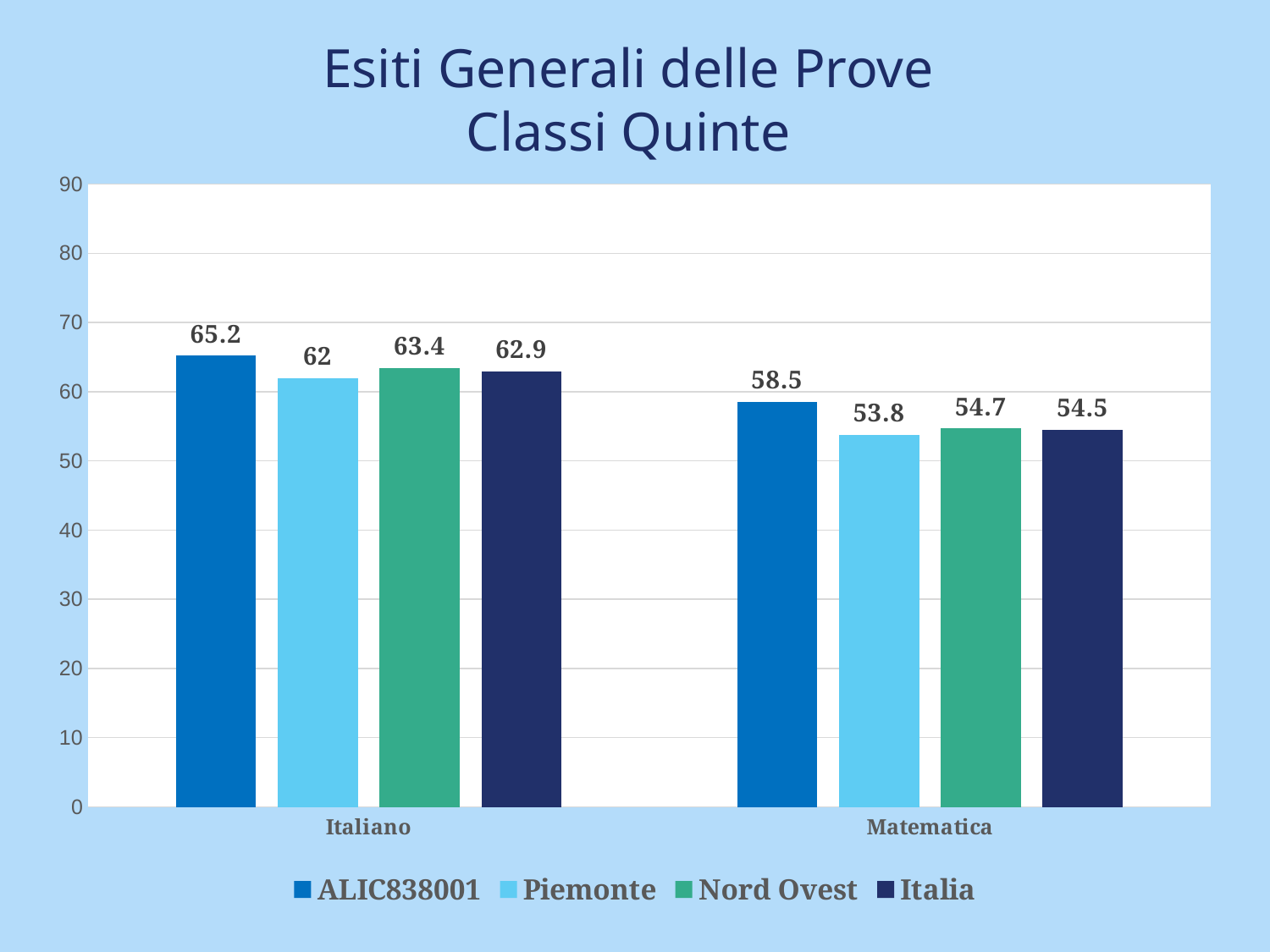
Which series has the highest value in Matematica? ALIC838001 What is the value for Nord Ovest in Italiano? 63.4 What is the difference between the ALIC838001 values for Italiano and Matematica? 6.7 What kind of chart is shown on the slide? Bar chart How many series does the legend list? 4 What is the value for Italia in Matematica? 54.5 Which series has the lowest value in Italiano? Piemonte What is the value for Piemonte in Matematica? 53.8 What is the value for ALIC838001 in Italiano? 65.2 How many categories are shown on the x axis? 2 What is the title of the chart? Esiti Generali delle Prove Classi Quinte Which is larger: the Nord Ovest value in Italiano or the Italia value in Italiano? Nord Ovest